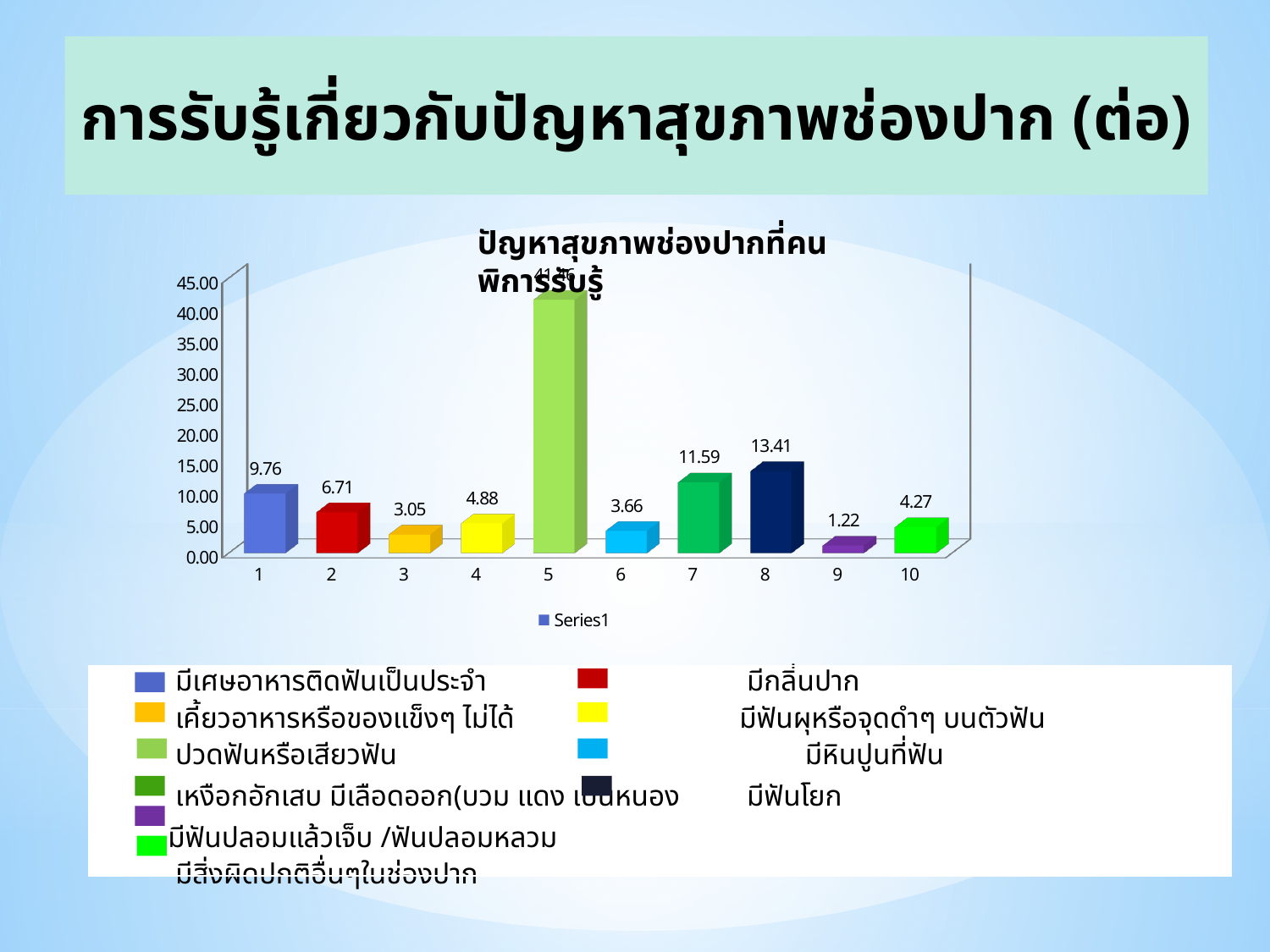
Is the value for category 5 greater or less than 40.00? greater What kind of chart is shown on the slide? bar chart What is the value for category 8? 13.41 Which category has the lowest value? 9 Which category has the highest value? 5 How many categories are shown on the x axis? 10 What is the difference between the values for category 8 and category 7? 1.82 What is the value for category 7? 11.59 Which is larger, the value for category 2 or the value for category 4? category 2 What is the value for category 1? 9.76 How many series does the legend list? 1 What is the value for category 9? 1.22